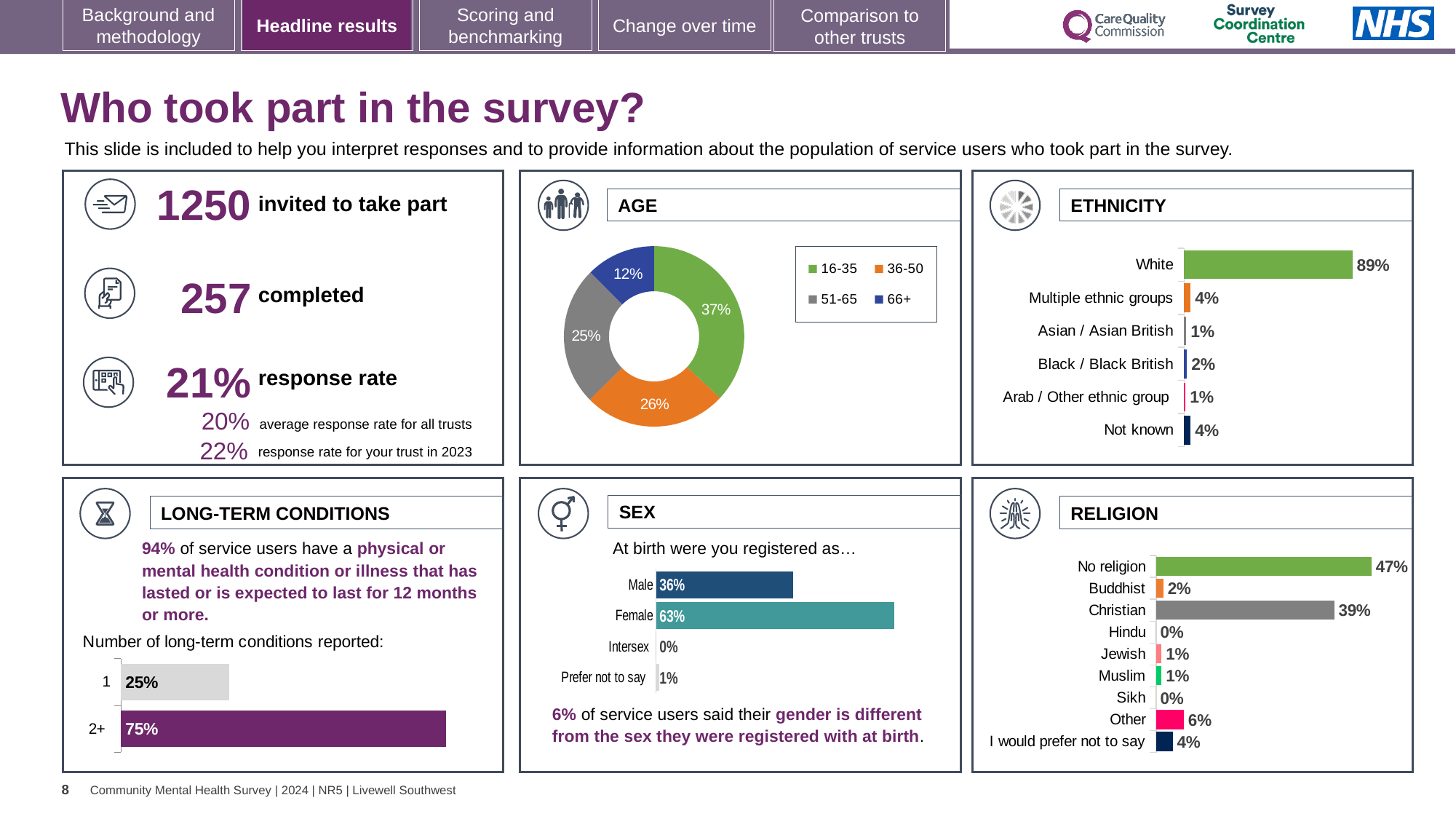
In the ETHNICITY chart, what is the value for Black / Black British? 2% In the LONG-TERM CONDITIONS chart, what is the difference between the 2+ and 1 categories? 50% How many categories are shown in the ETHNICITY chart? 6 What kind of chart is the AGE chart? Donut (pie) chart In the RELIGION chart, what is the value for Christian? 39% In the ETHNICITY chart, which category has the highest value? White In the SEX chart, what is the value for Female? 63% In the AGE chart, what share of respondents were aged 16-35? 37% In the SEX chart, which is larger, Male or Female? Female In the AGE chart, which age group has the smallest share? 66+ In the ETHNICITY chart, what is the difference between White and Multiple ethnic groups? 85% How many age groups does the legend of the AGE chart list? 4